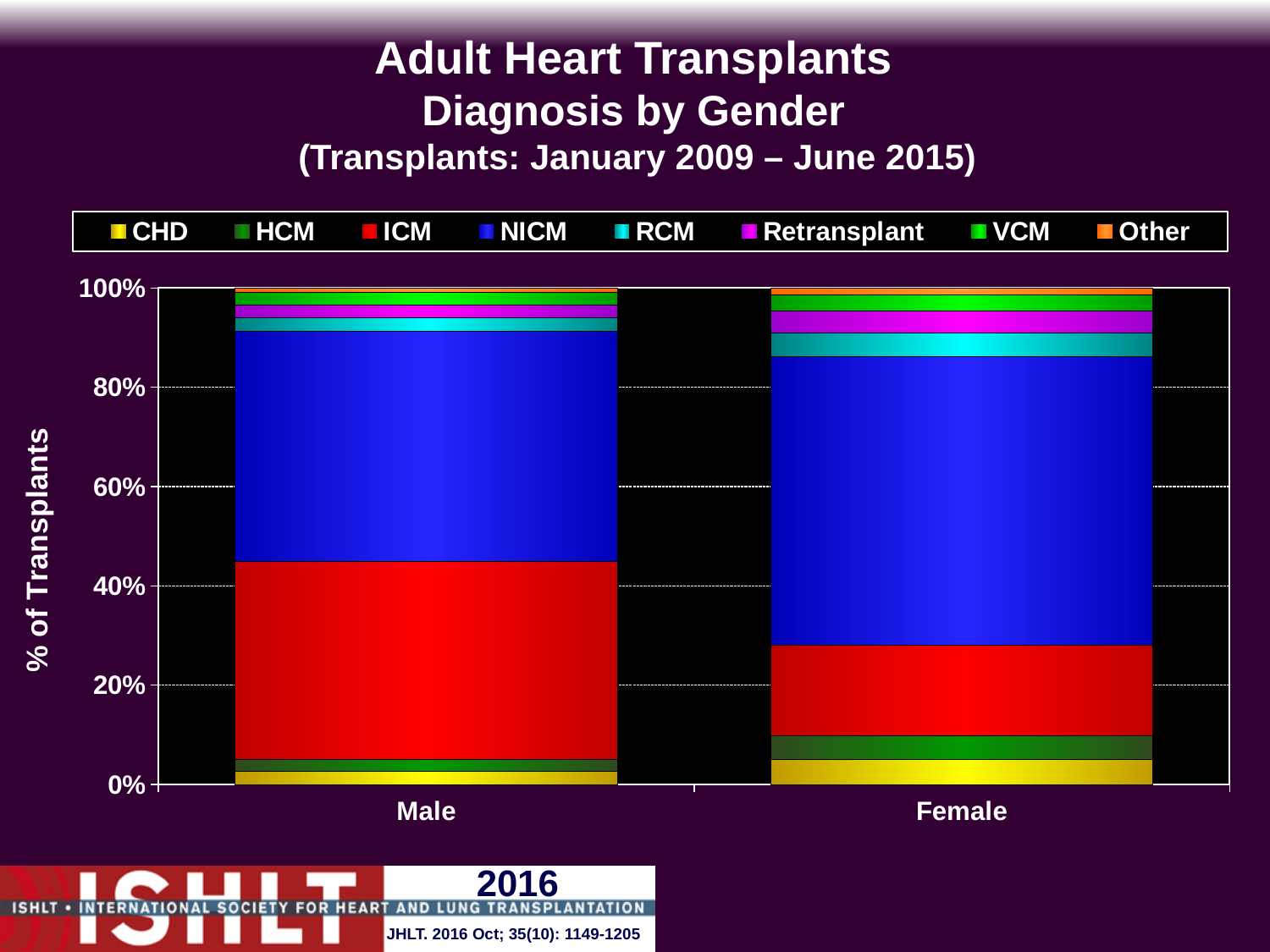
Is the NICM share for Female greater or less than 40%? greater What kind of chart is shown on the slide? stacked bar chart What is the date range of transplants given in the chart title? January 2009 – June 2015 What is the label of the y axis? % of Transplants Which gender has the larger NICM share, Male or Female? Female Which gender has the larger ICM share, Male or Female? Male Which diagnosis makes up the largest share of the Female bar? NICM How many series does the legend list? 8 What is the total of the stacked bar for Male? 100% How many categories are shown on the x axis? 2